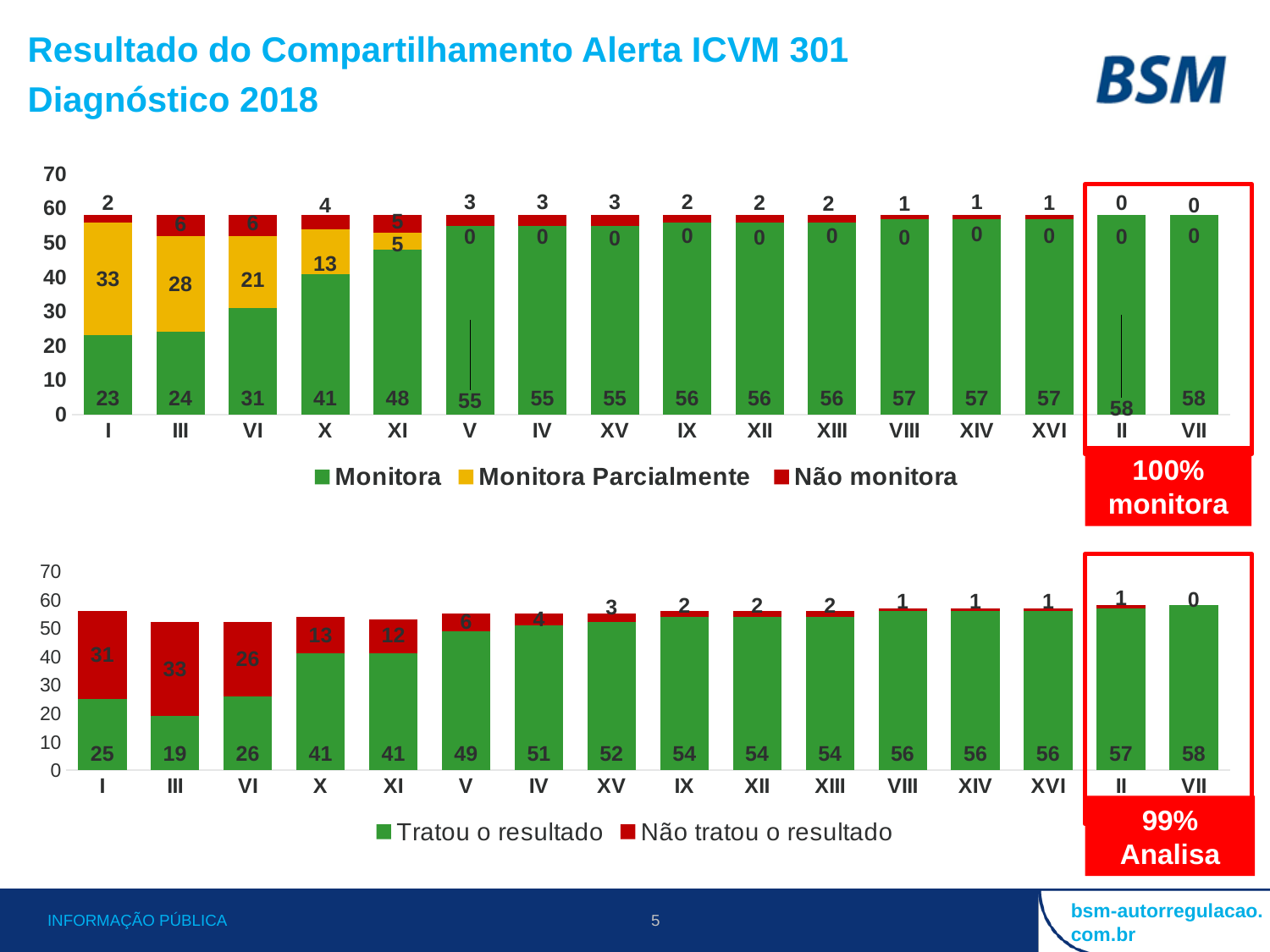
What kind of chart is the bottom chart? Stacked bar chart In the bottom chart, what is the Tratou o resultado value for category VI? 26 In the bottom chart, how many categories are shown on the x axis? 16 In the top chart, which category has the lowest Monitora value? I In the top chart, what is the Monitora value for category I? 23 In the bottom chart, what is the difference between the Tratou o resultado values for categories VII and I? 33 In the top chart, how many series does the legend list? 3 In the bottom chart, which category has the highest Tratou o resultado value? VII In the top chart, what is the Monitora Parcialmente value for category III? 28 In the bottom chart, what is the Não tratou o resultado value for category III? 33 In the top chart, what is the total of the stacked bar for category I? 58 In the top chart, what is the Não monitora value for category X? 4